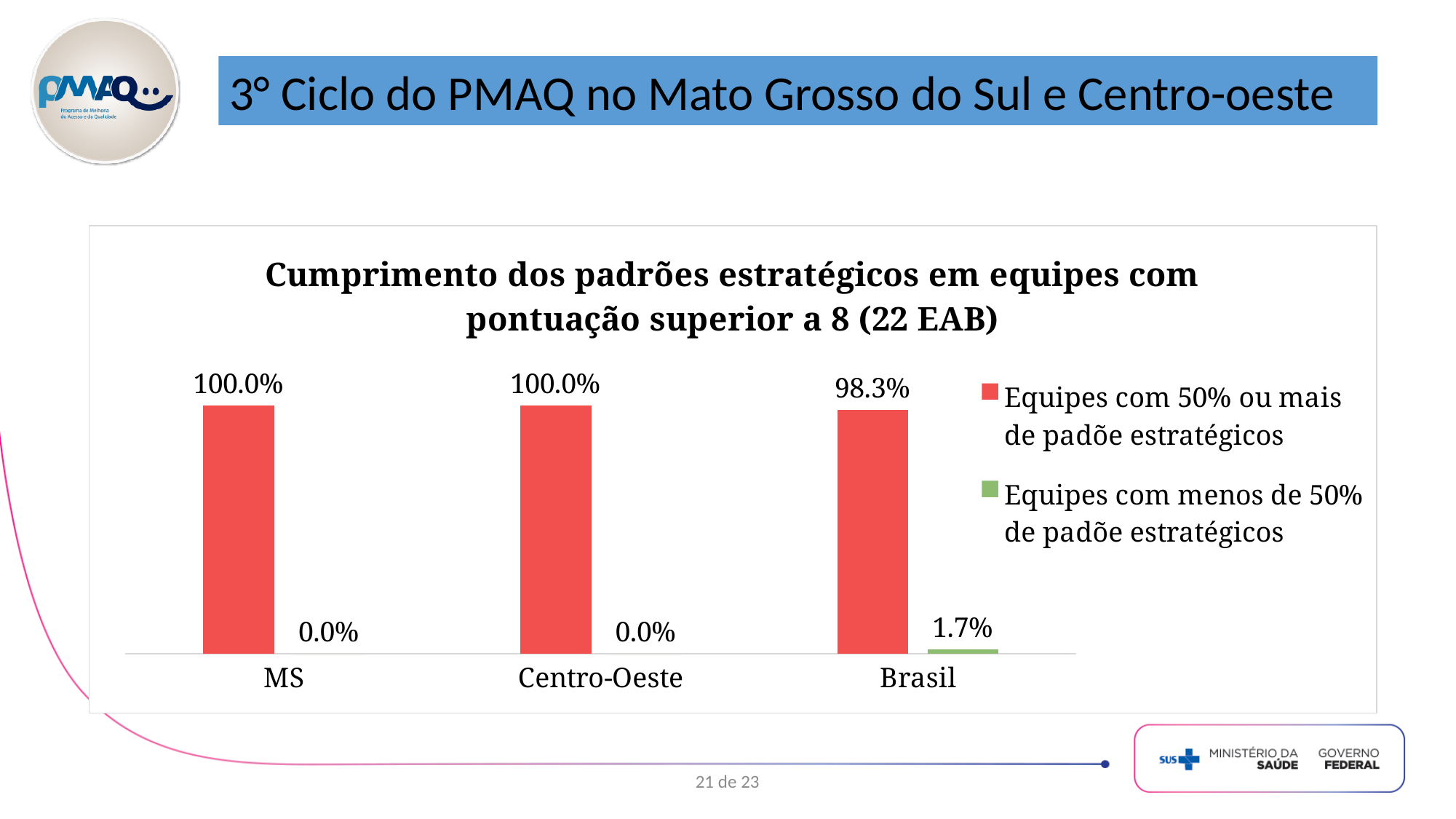
What is the value for Centro-Oeste in the series 'Equipes com menos de 50% de padõe estratégicos'? 0.0% What kind of chart is shown? Bar chart What is the value for Brasil in the series 'Equipes com 50% ou mais de padõe estratégicos'? 98.3% How many series does the legend list? 2 What is the difference between the two series values for Brasil? 96.6% What is the value for Brasil in the series 'Equipes com menos de 50% de padõe estratégicos'? 1.7% Which category has the highest value in the series 'Equipes com menos de 50% de padõe estratégicos'? Brasil What colour represents the series 'Equipes com menos de 50% de padõe estratégicos'? Green Which is larger for Brasil: 'Equipes com 50% ou mais de padõe estratégicos' or 'Equipes com menos de 50% de padõe estratégicos'? Equipes com 50% ou mais de padõe estratégicos Which category has the lowest value in the series 'Equipes com 50% ou mais de padõe estratégicos'? Brasil What is the value for MS in the series 'Equipes com 50% ou mais de padõe estratégicos'? 100.0% How many categories are shown on the x axis? 3